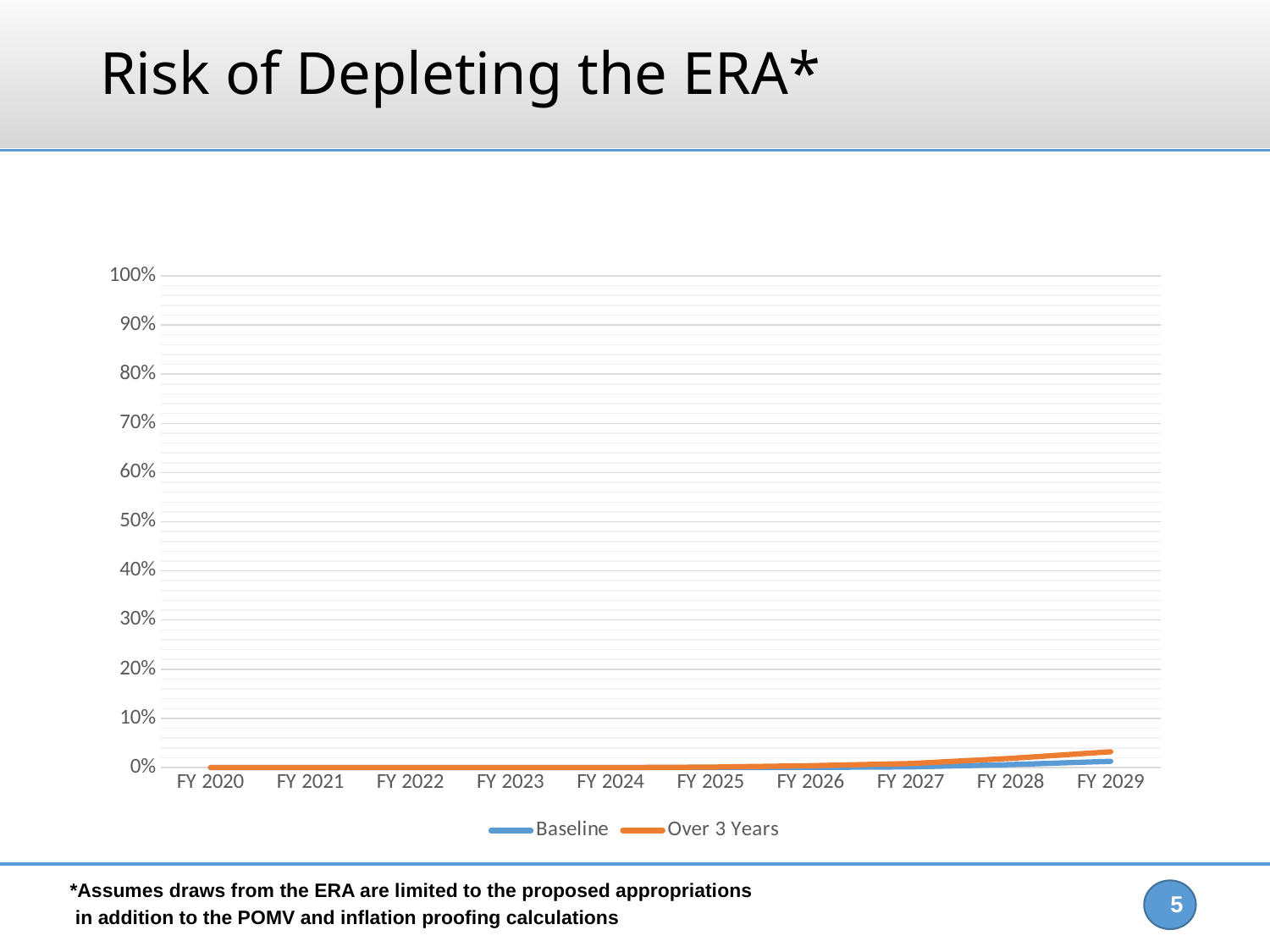
How many fiscal years are plotted along the x axis? 10 Is the value for Baseline in FY 2029 greater or less than 10%? less Do the values for Over 3 Years rise or fall from FY 2020 to FY 2029? rise What is the first fiscal year shown on the x axis? FY 2020 Which fiscal year has the highest value for the Over 3 Years series? FY 2029 Which colour is used for the Over 3 Years series? orange What kind of chart is shown on the slide? line chart How many series does the legend list? 2 In FY 2029, which series has the higher value, Baseline or Over 3 Years? Over 3 Years What are the two series named in the legend? Baseline and Over 3 Years What is the highest value shown on the y axis? 100% Is the value for Over 3 Years in FY 2029 greater or less than 10%? less